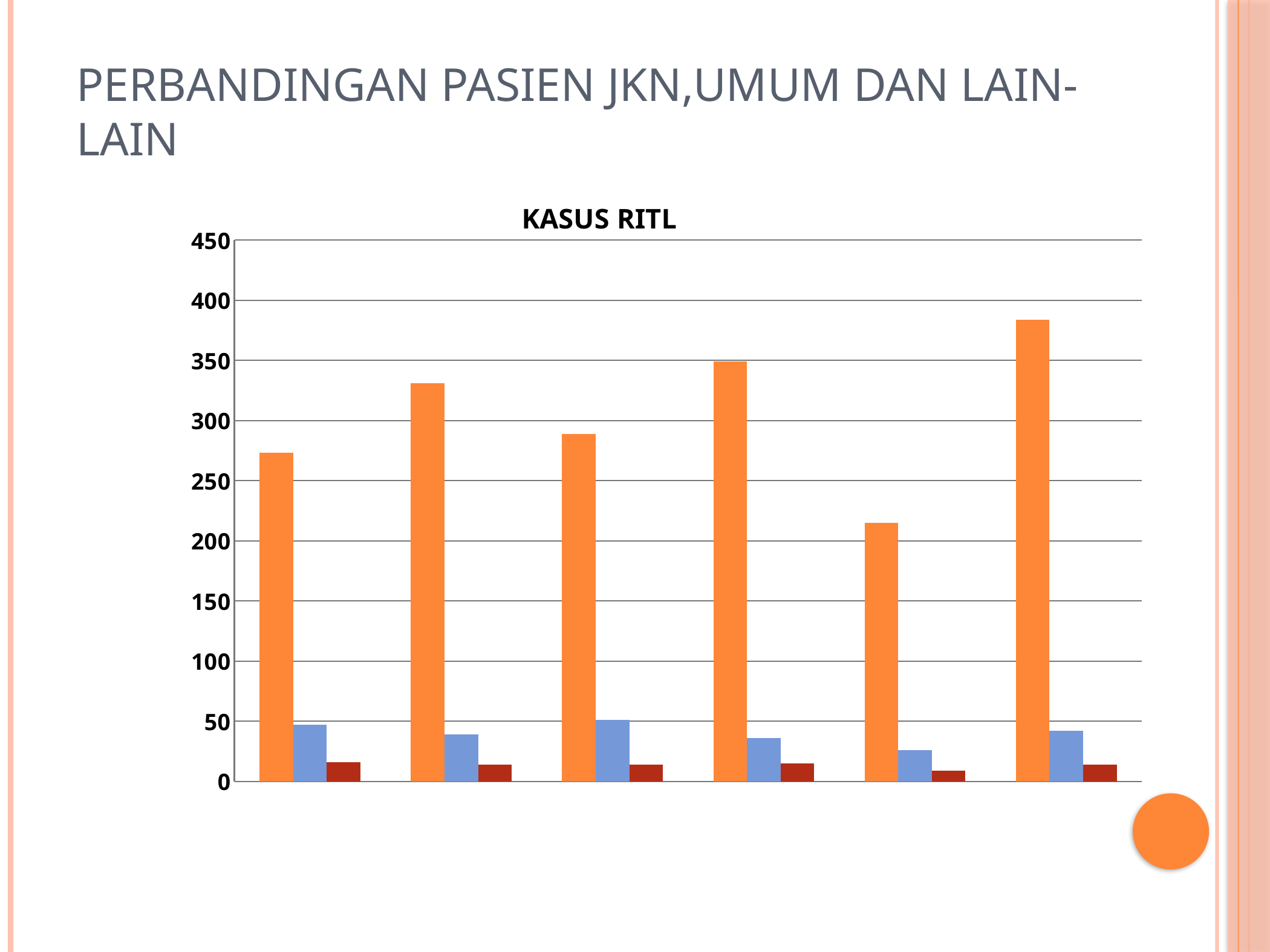
What kind of chart is shown on the slide? bar chart Which group has the tallest orange bar? the sixth (last) group Is the orange bar in the fifth group greater or less than 250? less Is the blue bar in the fifth group greater or less than 50? less What is the title of the chart? KASUS RITL How many differently coloured bar series appear in each group? 3 Is the orange bar in the sixth group greater or less than 350? greater Is the orange bar in the second group larger or smaller than the orange bar in the third group? larger Which group has the shortest blue bar? the fifth group Which group has the shortest orange bar? the fifth group How many groups of bars are plotted along the x axis? 6